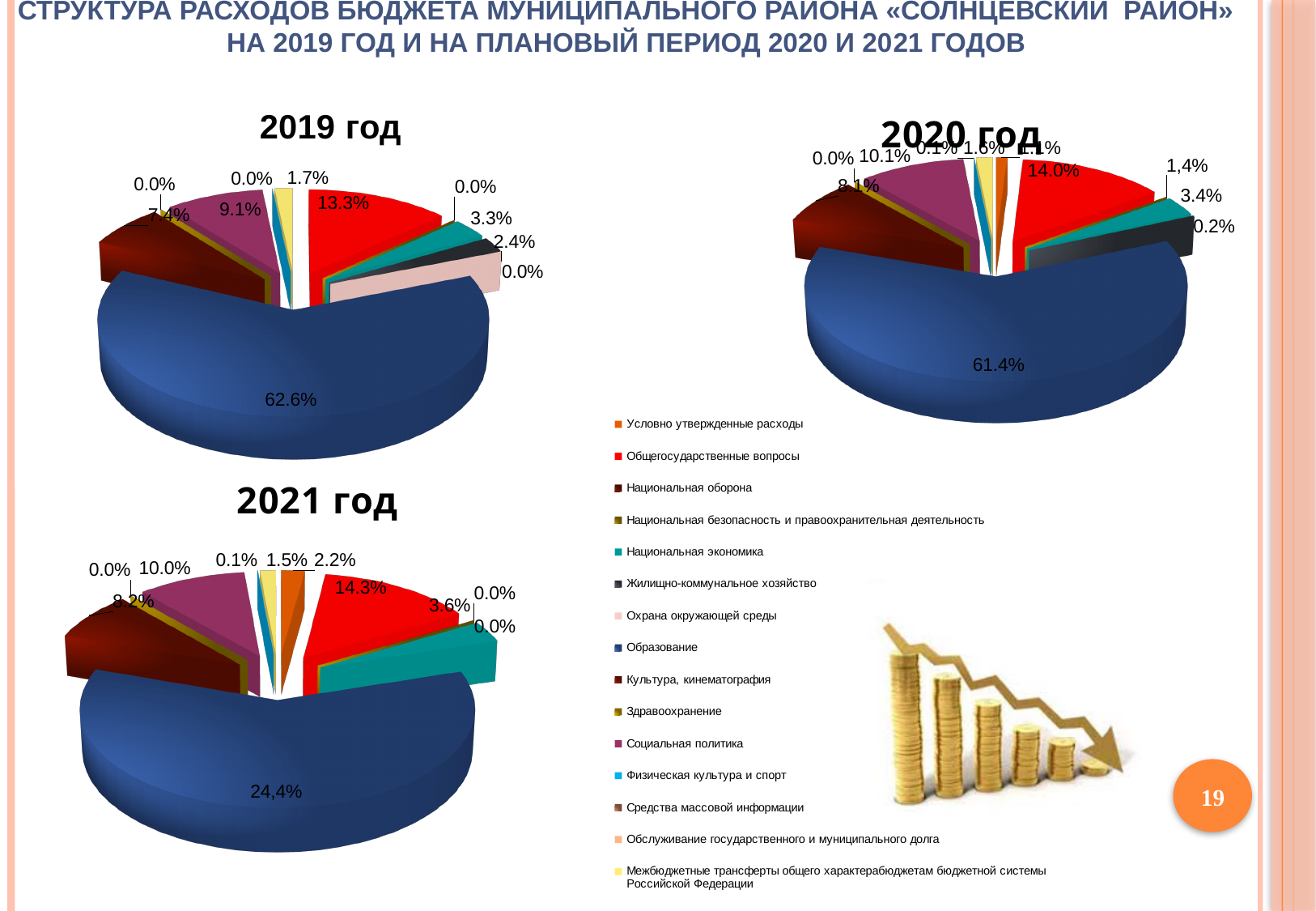
How many categories does the legend list? 15 In the 2020 год chart, what is the value of the largest slice? 61.4% Which chart shows a larger share for Образование (the blue slice): 2019 год or 2020 год? 2019 год In the 2020 год chart, what share is shown for Общегосударственные вопросы (the red slice)? 14.0% In the 2019 год chart, what is the value of the largest slice? 62.6% How many pie charts are on the slide? 3 What is the difference between the Образование share in the 2019 год chart (62.6%) and in the 2020 год chart (61.4%)? 1.2 percentage points In the 2021 год chart, what share is shown for Общегосударственные вопросы (the red slice)? 14.3% In the 2021 год chart, what is the value of the largest slice? 24,4% In the 2019 год chart, what share is shown for Социальная политика (the purple slice)? 9.1% In the 2019 год chart, what share is shown for Общегосударственные вопросы (the red slice)? 13.3% What kind of charts are shown on the slide? Pie charts